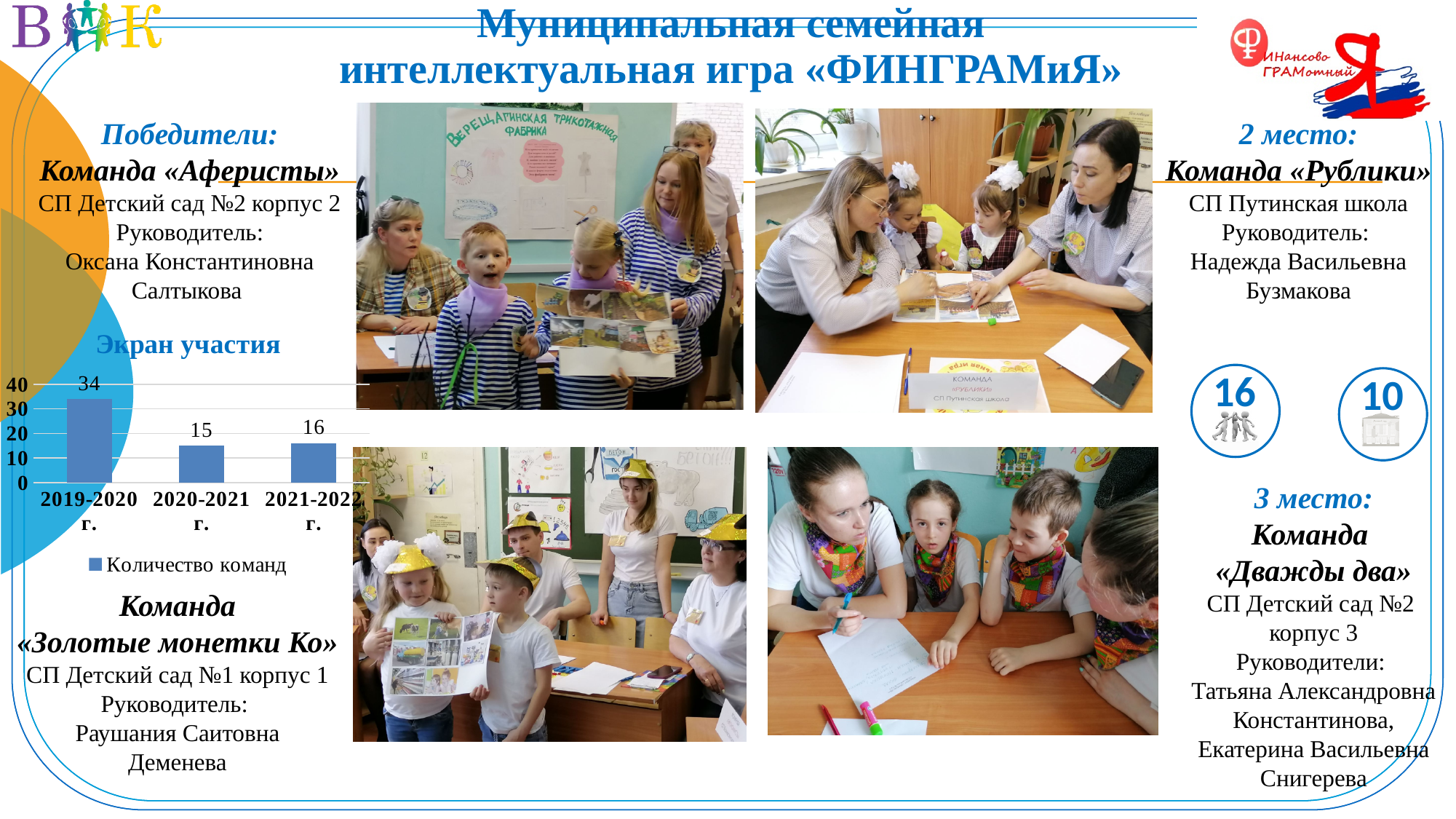
How many categories are shown in the chart? 3 Which is larger: the value for 2019-2020 г. or the value for 2020-2021 г.? 2019-2020 г. What is the value for 2019-2020 г. in the chart? 34 What is the value for 2021-2022 г. in the chart? 16 Is the value for 2019-2020 г. greater or less than 30? greater What is the title of the chart on the slide? Экран участия What is the difference between the values for 2021-2022 г. and 2020-2021 г.? 1 Which category has the lowest value in the chart? 2020-2021 г. What kind of chart is shown on the slide? bar chart Which category has the highest value in the chart? 2019-2020 г. What is the difference between the values for 2019-2020 г. and 2021-2022 г.? 18 What is the value for 2020-2021 г. in the chart? 15